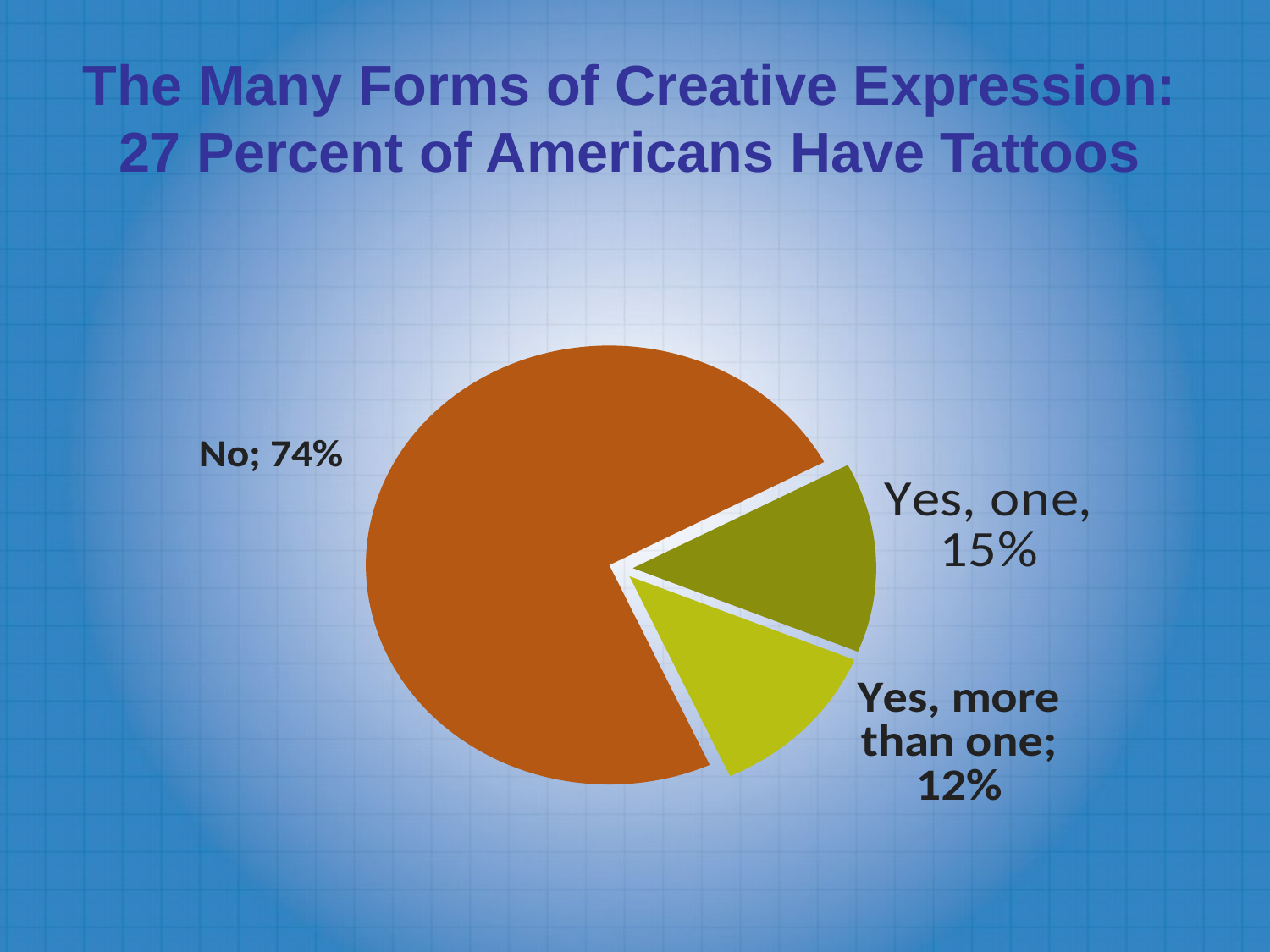
What kind of chart is shown on the slide? pie chart What is the difference in percentage points between the "Yes, one" slice and the "Yes, more than one" slice? 3 Which slice of the pie is the largest? No What percentage of the pie is labelled "No"? 74% What percentage of the pie is labelled "Yes, more than one"? 12% What is the difference in percentage points between the "No" slice and the "Yes, one" slice? 59 What is the combined percentage of the two "Yes" slices? 27% Which slice of the pie is the smallest? Yes, more than one What is the title of the slide containing the pie chart? The Many Forms of Creative Expression: 27 Percent of Americans Have Tattoos What percentage of the pie is labelled "Yes, one"? 15% How many slices does the pie chart have? 3 Which is larger, the "Yes, one" slice or the "Yes, more than one" slice? Yes, one